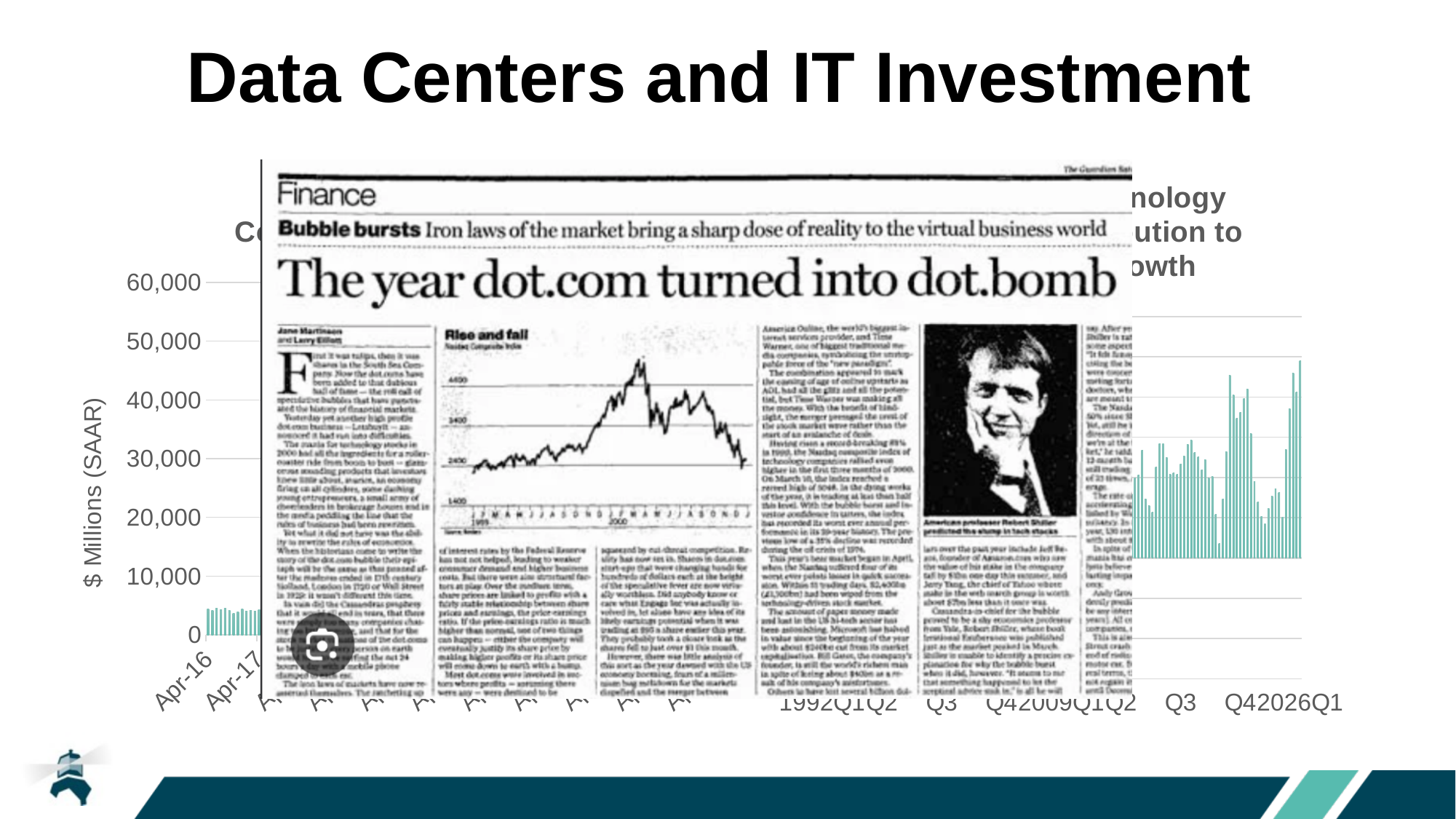
On the chart on the left of the slide, what is the highest value shown on the vertical axis? 60,000 On the chart on the left of the slide, what is the label of the vertical axis? $ Millions (SAAR) What kind of chart is the chart on the left of the slide, with the $ Millions (SAAR) axis? bar chart On the chart on the left of the slide, is the value for Apr-16 greater or less than 10,000? less